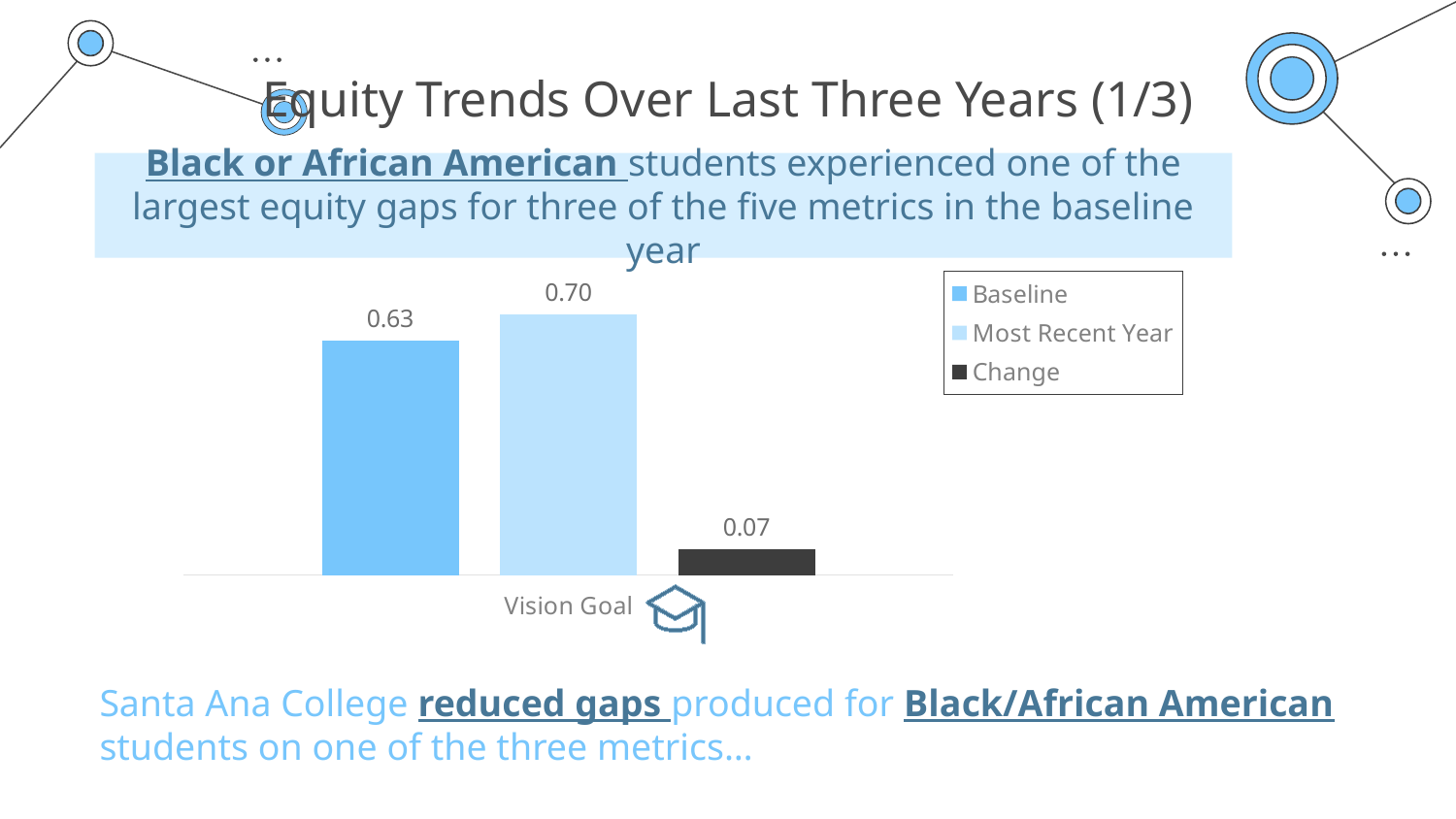
What is the difference between the Most Recent Year and Baseline values for Vision Goal? 0.07 How many categories are shown on the x axis? 1 What is the Change value for Vision Goal? 0.07 Which series is shown in dark grey/black in the legend? Change Which series has the lowest value for Vision Goal? Change What kind of chart is shown on the slide? Bar chart What is the Most Recent Year value for Vision Goal? 0.70 What is the label of the category on the x axis? Vision Goal How many series does the legend list? 3 What is the Baseline value for Vision Goal? 0.63 Which is larger for Vision Goal, the Baseline value or the Most Recent Year value? Most Recent Year Which series has the highest value for Vision Goal? Most Recent Year